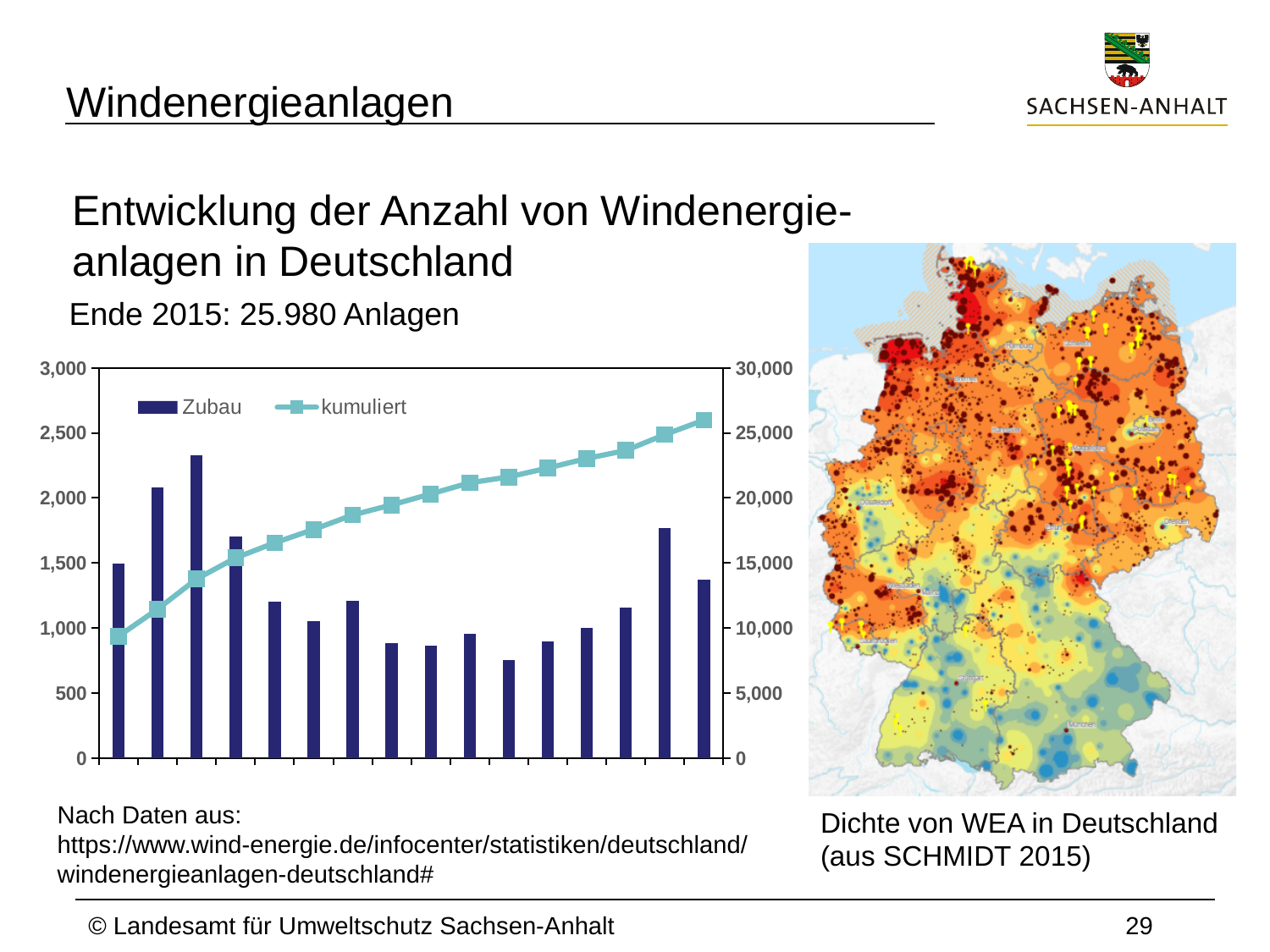
How many series does the legend of the chart list? 2 Which bar is the tallest in the chart? The third bar from the left Is the value of the first Zubau bar greater or less than 1,000? greater Is the value of the third Zubau bar greater or less than 2,000? greater What kind of chart is shown on the left of the slide? A combined bar and line chart What are the two series named in the chart legend? Zubau and kumuliert Is the last point of the kumuliert line greater or less than 25,000 on the right axis? greater How many bars are plotted in the chart? 16 Which bar is the shortest in the chart? The eleventh bar from the left Does the kumuliert line rise or fall from left to right? Rises Which is larger, the second Zubau bar or the fourth Zubau bar? The second bar Which series is drawn as bars in the chart? Zubau